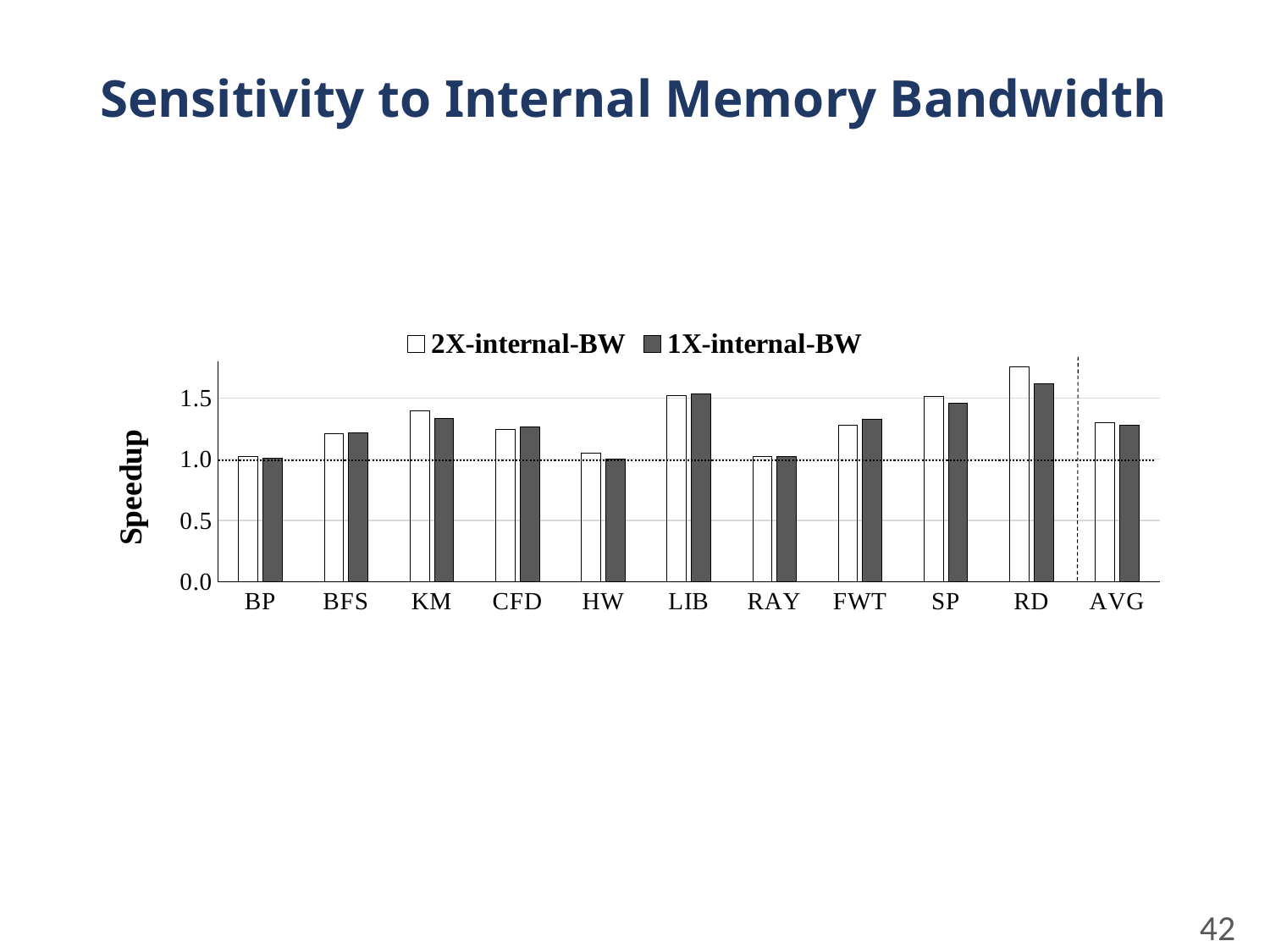
Which category has the highest 1X-internal-BW speedup? RD Is the 2X-internal-BW value for RD greater or less than 1.5? greater Which category has the highest 2X-internal-BW speedup? RD Is the 2X-internal-BW value for CFD greater or less than 1.5? less Which has the larger 2X-internal-BW speedup, KM or BFS? KM How many categories are shown along the x axis? 11 For RD, which series has the larger speedup, 2X-internal-BW or 1X-internal-BW? 2X-internal-BW Is the 2X-internal-BW value for KM greater or less than 1.5? less What is the label on the y axis? Speedup How many series does the legend list? 2 What kind of chart is shown on the slide? bar chart